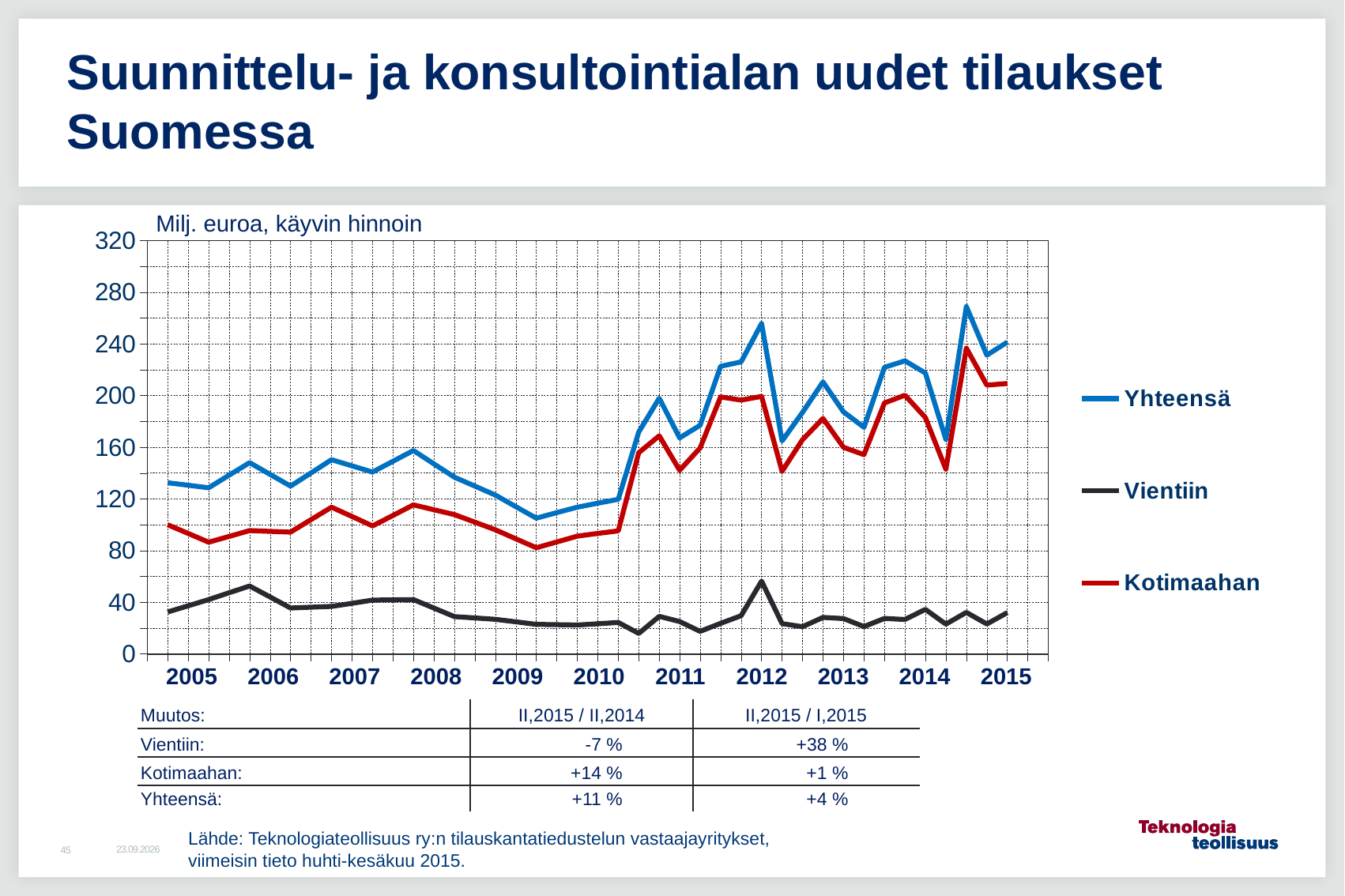
How many series does the legend list? 3 What unit is given above the chart for the values? Milj. euroa, käyvin hinnoin How many years are labelled on the x axis? 11 Which series has the highest values throughout the chart? Yhteensä Is the peak value of Yhteensä in 2014 greater or less than 240? greater Which series has the lowest values throughout the chart? Vientiin Does the Kotimaahan series rise or fall between 2009 and 2011? rise Is the peak value of Vientiin in 2012 greater or less than 40? greater Which is larger in 2015, Kotimaahan or Vientiin? Kotimaahan What kind of chart is shown on the slide? line chart Is the lowest value of Yhteensä in 2009 greater or less than 120? less Which series are listed in the legend? Yhteensä, Vientiin, Kotimaahan